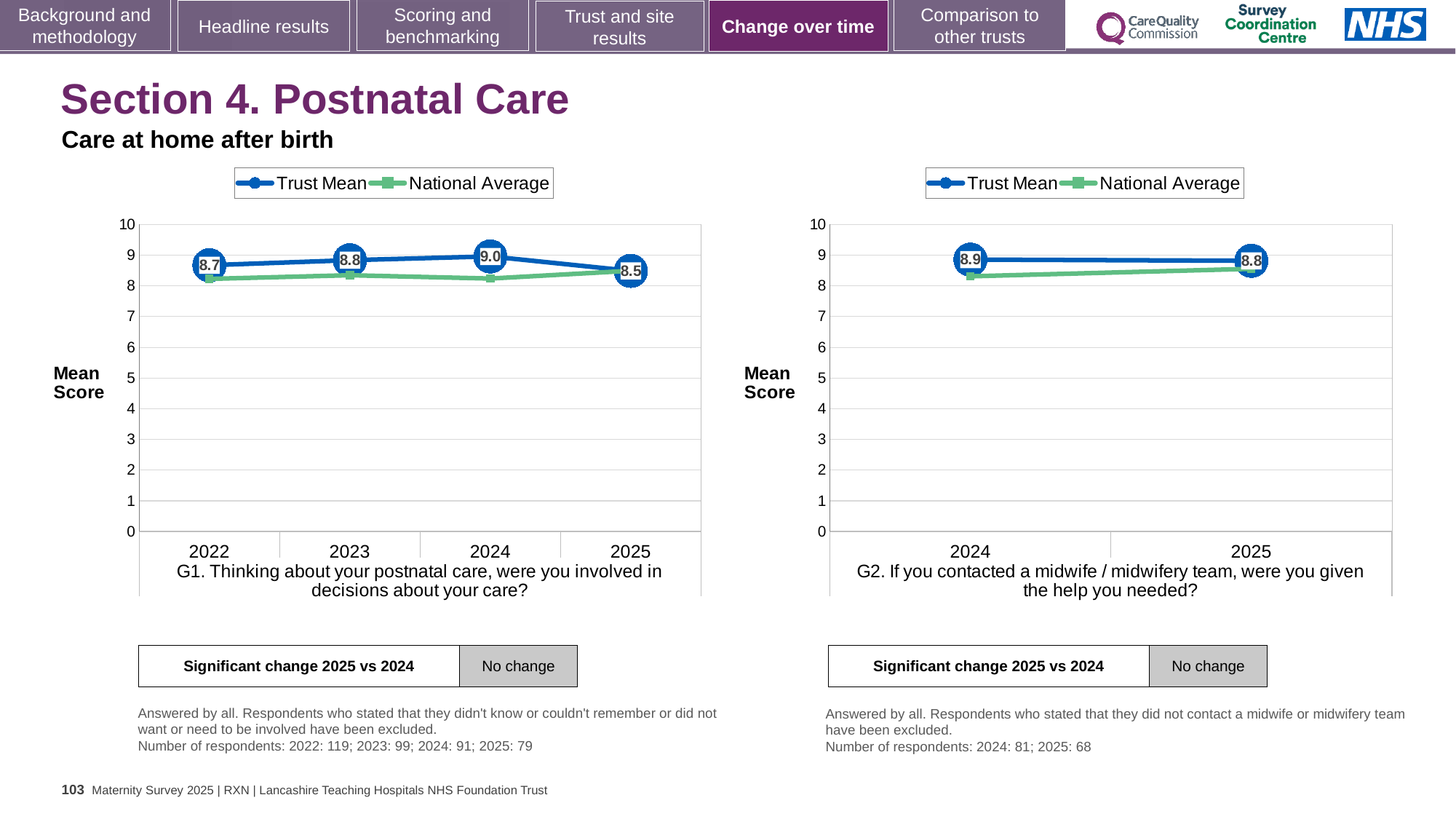
In the G1 chart (left), what is the Trust Mean for 2022? 8.7 In the G2 chart (right), is the National Average for 2024 greater or less than 9? less In the G1 chart (left), what is the difference between the Trust Mean for 2024 and 2025? 0.5 What type of chart is the G1 chart (left)? line chart How many years are shown on the x axis of the G1 chart (left)? 4 In the G1 chart (left), what is the Trust Mean for 2024? 9.0 How many series does the legend of the G2 chart (right) list? 2 In the G1 chart (left), which year has the lowest Trust Mean? 2025 In the G1 chart (left), which year has the highest Trust Mean? 2024 In the G1 chart (left), is the Trust Mean for 2023 higher or lower than the Trust Mean for 2025? higher In the G2 chart (right), what is the difference between the Trust Mean for 2024 and 2025? 0.1 In the G2 chart (right), what is the Trust Mean for 2025? 8.8